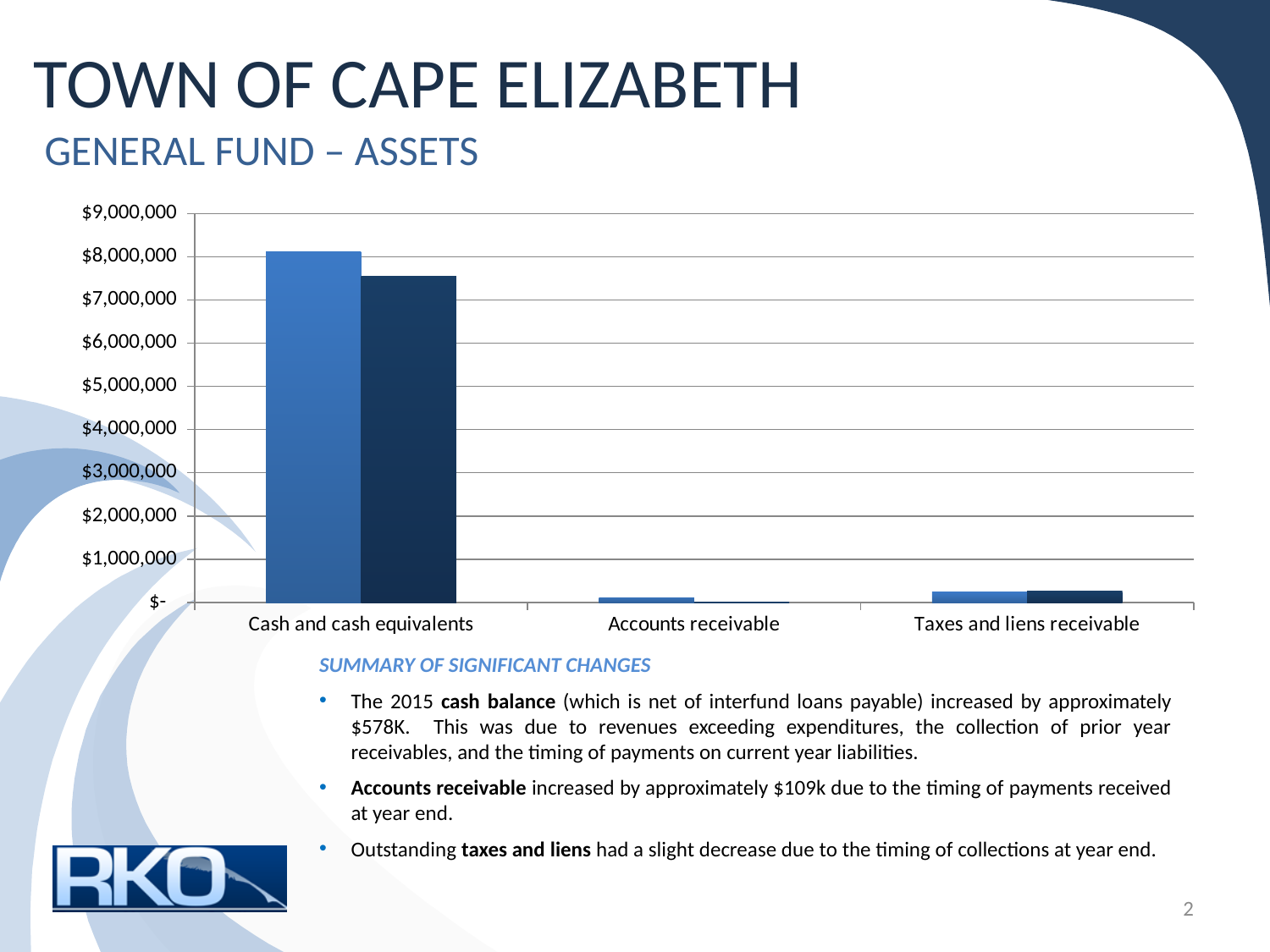
Is the light blue bar for Taxes and liens receivable greater or less than $1,000,000? less Which category has taller bars, Accounts receivable or Taxes and liens receivable? Taxes and liens receivable What kind of chart is shown on the slide? Bar chart Which category has the lowest bars in the chart? Accounts receivable How many categories are shown on the x axis of the chart? 3 Is the dark blue bar for Cash and cash equivalents greater or less than $7,000,000? greater Is the light blue bar for Accounts receivable greater or less than $1,000,000? less What is the highest value labelled on the y axis of the chart? $9,000,000 For Cash and cash equivalents, which bar is taller, the light blue bar or the dark blue bar? The light blue bar Which category has the highest bars in the chart? Cash and cash equivalents